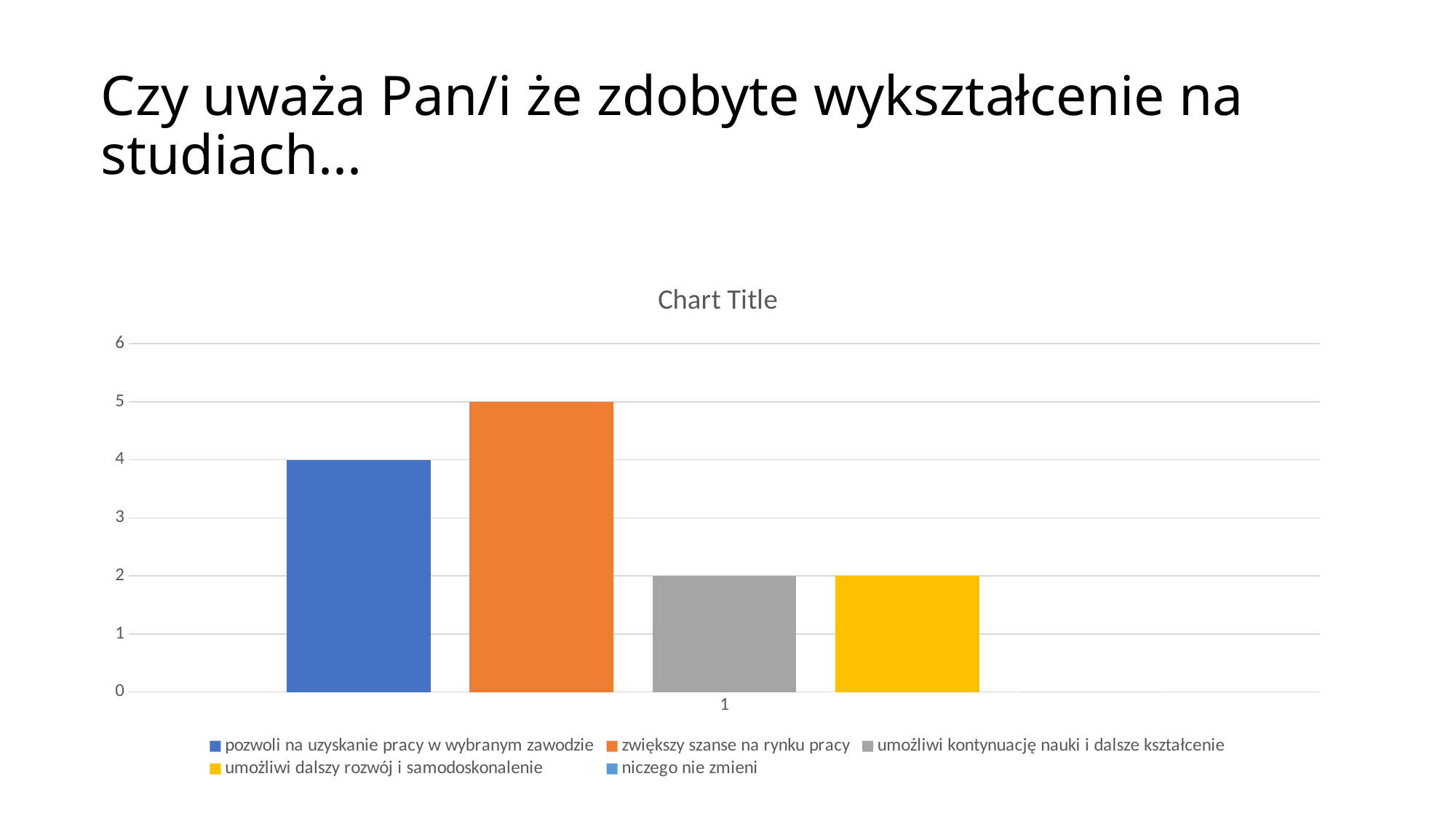
What kind of chart is shown on the slide? bar chart How many series does the legend list? 5 What is the value for "umożliwi kontynuację nauki i dalsze kształcenie"? 2 Which is larger: the value for "pozwoli na uzyskanie pracy w wybranym zawodzie" or the value for "umożliwi kontynuację nauki i dalsze kształcenie"? pozwoli na uzyskanie pracy w wybranym zawodzie What is the value for "pozwoli na uzyskanie pracy w wybranym zawodzie"? 4 What is the difference between the values for "zwiększy szanse na rynku pracy" and "pozwoli na uzyskanie pracy w wybranym zawodzie"? 1 What is the value for "umożliwi dalszy rozwój i samodoskonalenie"? 2 Which series has the highest value? zwiększy szanse na rynku pracy What is the title shown above the chart? Chart Title Is the value for "zwiększy szanse na rynku pracy" greater or less than 3? greater What is the value for "zwiększy szanse na rynku pracy"? 5 What colour is the bar for "zwiększy szanse na rynku pracy"? orange